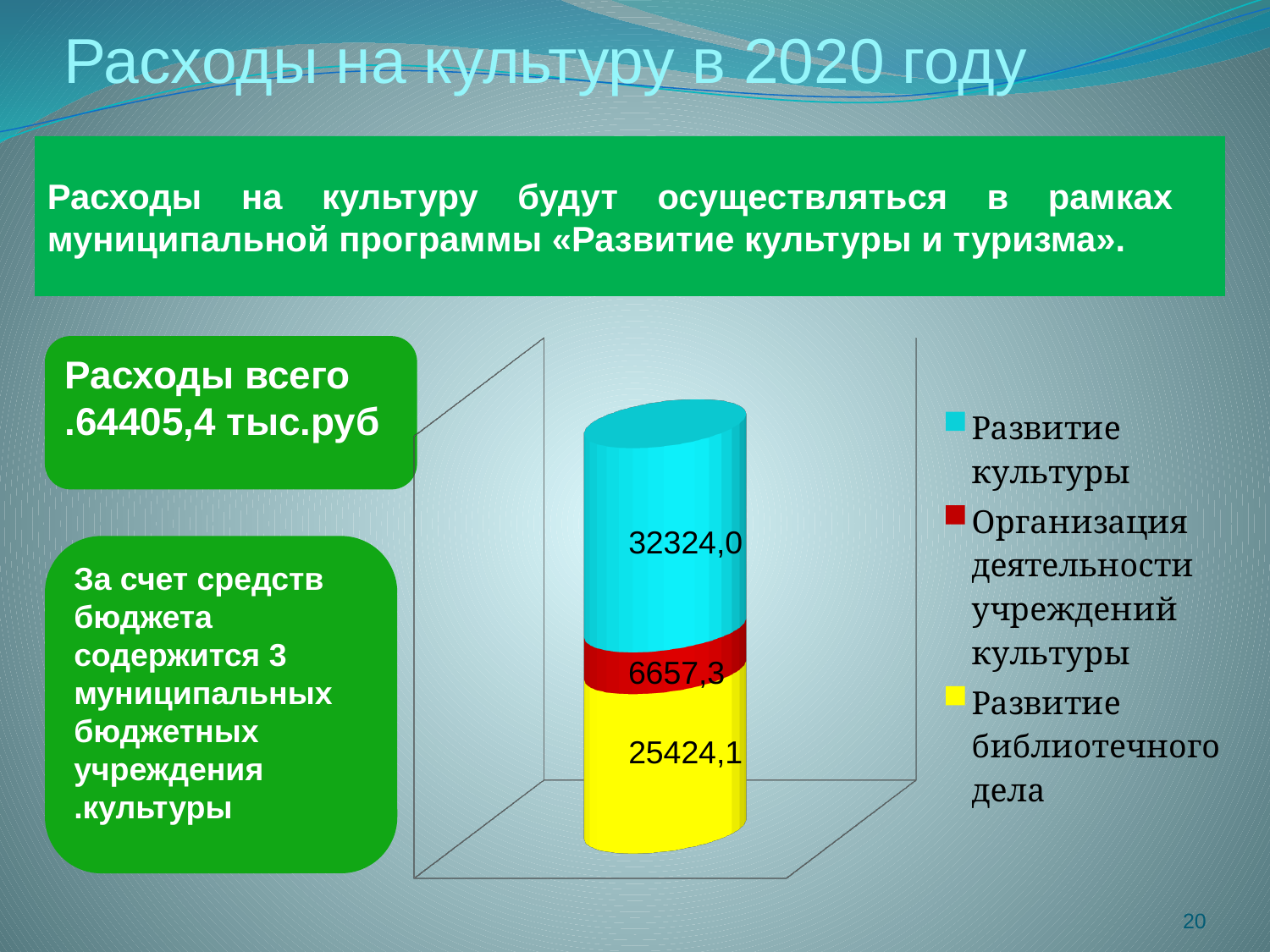
How many series does the legend list? 3 What value is shown for the "Организация деятельности учреждений культуры" segment? 6657,3 What value is shown for the "Развитие культуры" segment of the stacked bar? 32324,0 What kind of chart is shown on the slide? Stacked bar chart Which series has the smallest value in the stacked bar? Организация деятельности учреждений культуры What colour represents "Развитие библиотечного дела" in the chart? Yellow What value is shown for the "Развитие библиотечного дела" segment? 25424,1 Which is larger: the value for "Развитие библиотечного дела" or the value for "Организация деятельности учреждений культуры"? Развитие библиотечного дела What is the difference between the "Развитие культуры" value and the "Развитие библиотечного дела" value? 6899,9 What is the total of the stacked bar? 64405,4 Which series is shown in red in the chart? Организация деятельности учреждений культуры Which series has the largest value in the stacked bar? Развитие культуры